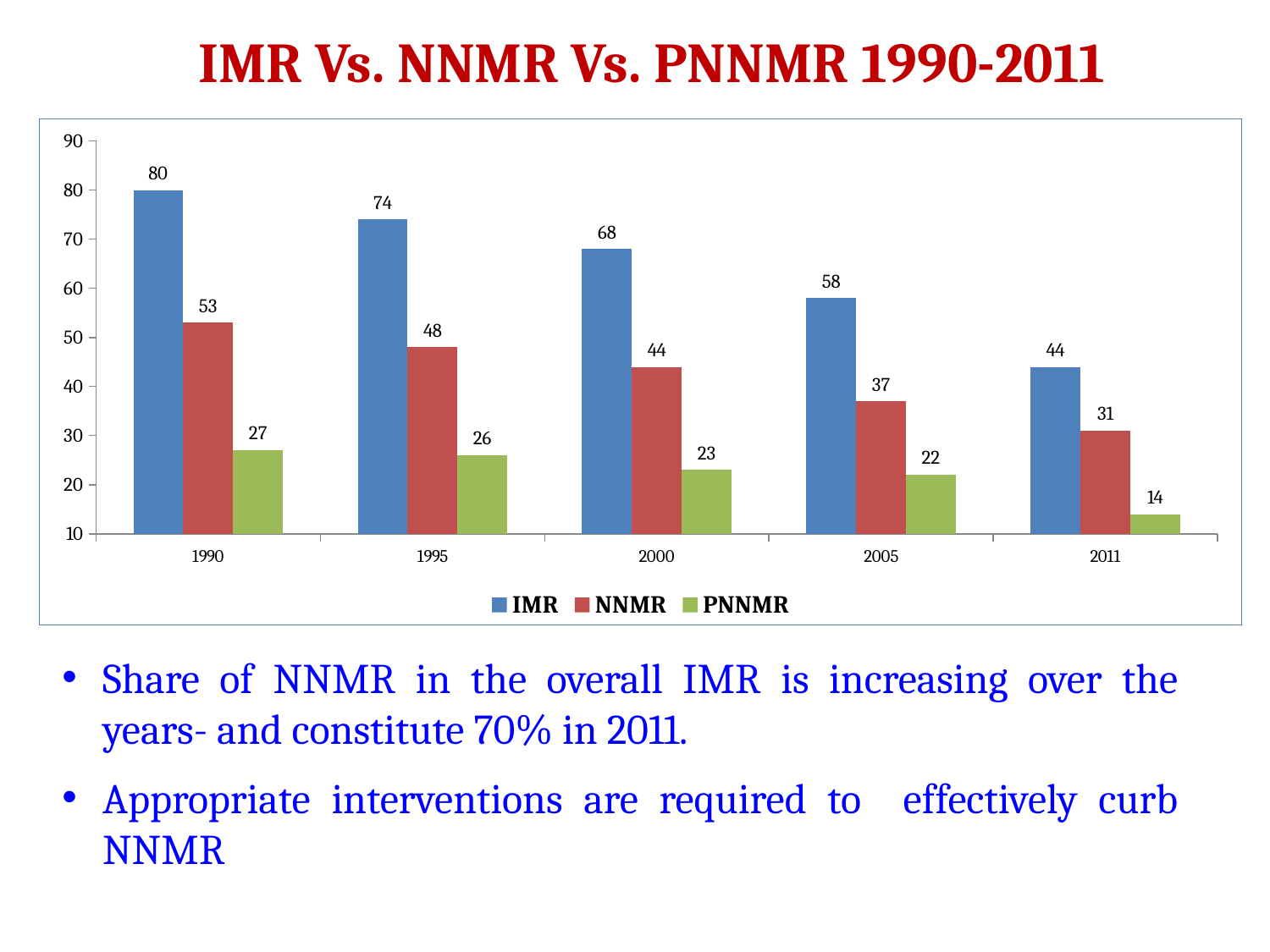
What is the difference between the IMR and NNMR values in 2000? 24 What is the title of the chart? IMR Vs. NNMR Vs. PNNMR 1990-2011 How many series does the legend list? 3 In which year is the PNNMR value lowest? 2011 How many years are shown on the x axis? 5 In which year is the IMR value highest? 1990 What kind of chart is shown on the slide? Bar chart Which is larger, the NNMR value in 1995 or the IMR value in 2011? NNMR in 1995 What is the NNMR value for 2005? 37 What is the PNNMR value for 2011? 14 Do the IMR values rise or fall from 1990 to 2011? Fall What is the IMR value for 1990? 80